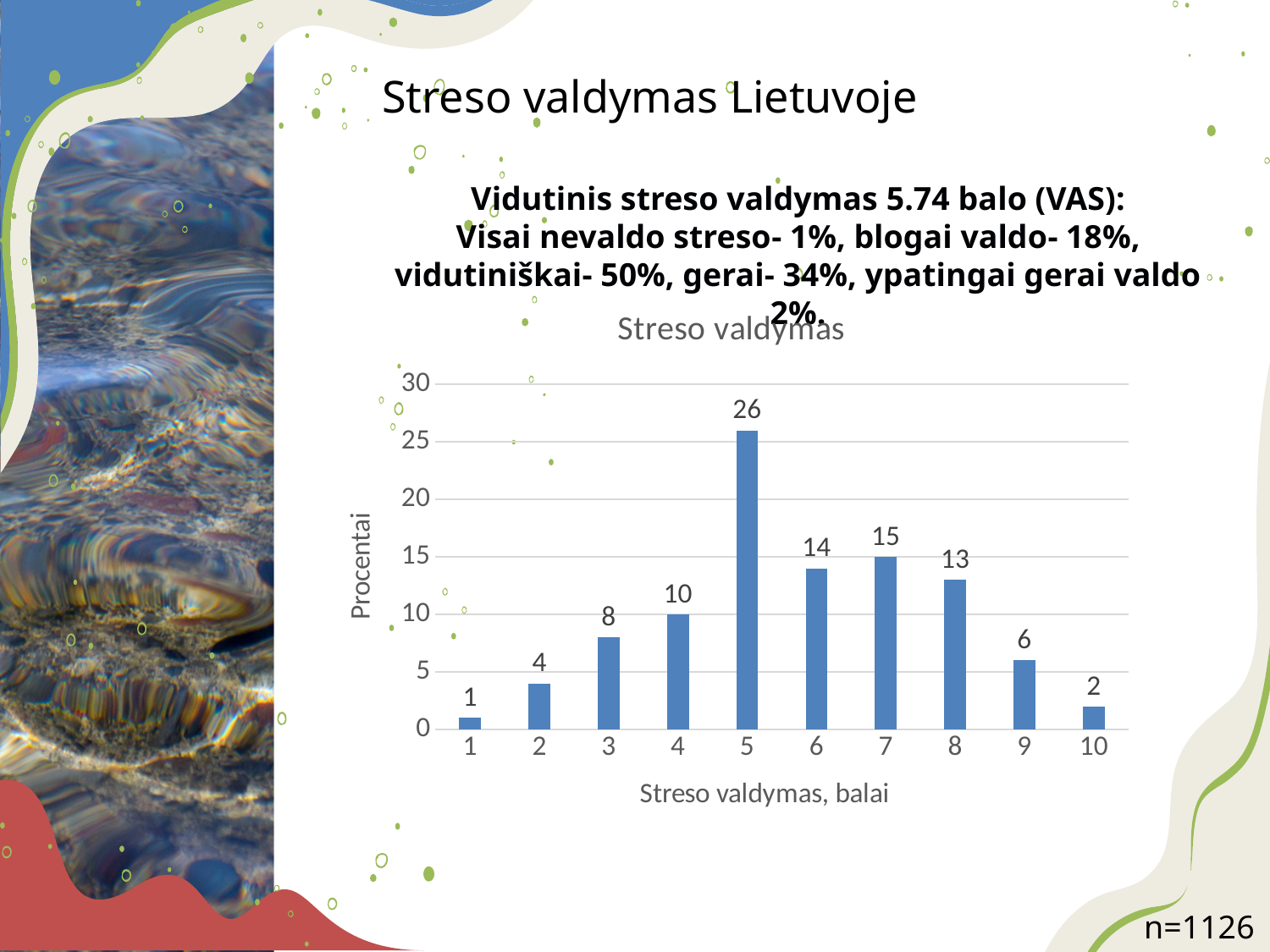
What is the value for category 8 in the chart? 13 Which category has the lowest value in the chart? 1 What is the label of the y axis of the chart? Procentai Which is larger, the value for category 6 or the value for category 7? 7 What is the value for category 2 in the chart? 4 What is the title of the chart? Streso valdymas Do the values rise or fall from category 5 to category 10? They mostly fall, but rise from category 6 to 7 How many categories are shown on the x axis of the chart? 10 Which category has the highest value in the chart? 5 What is the difference between the values for categories 5 and 7? 11 What is the value for category 5 in the chart? 26 What kind of chart is shown on the slide? bar chart